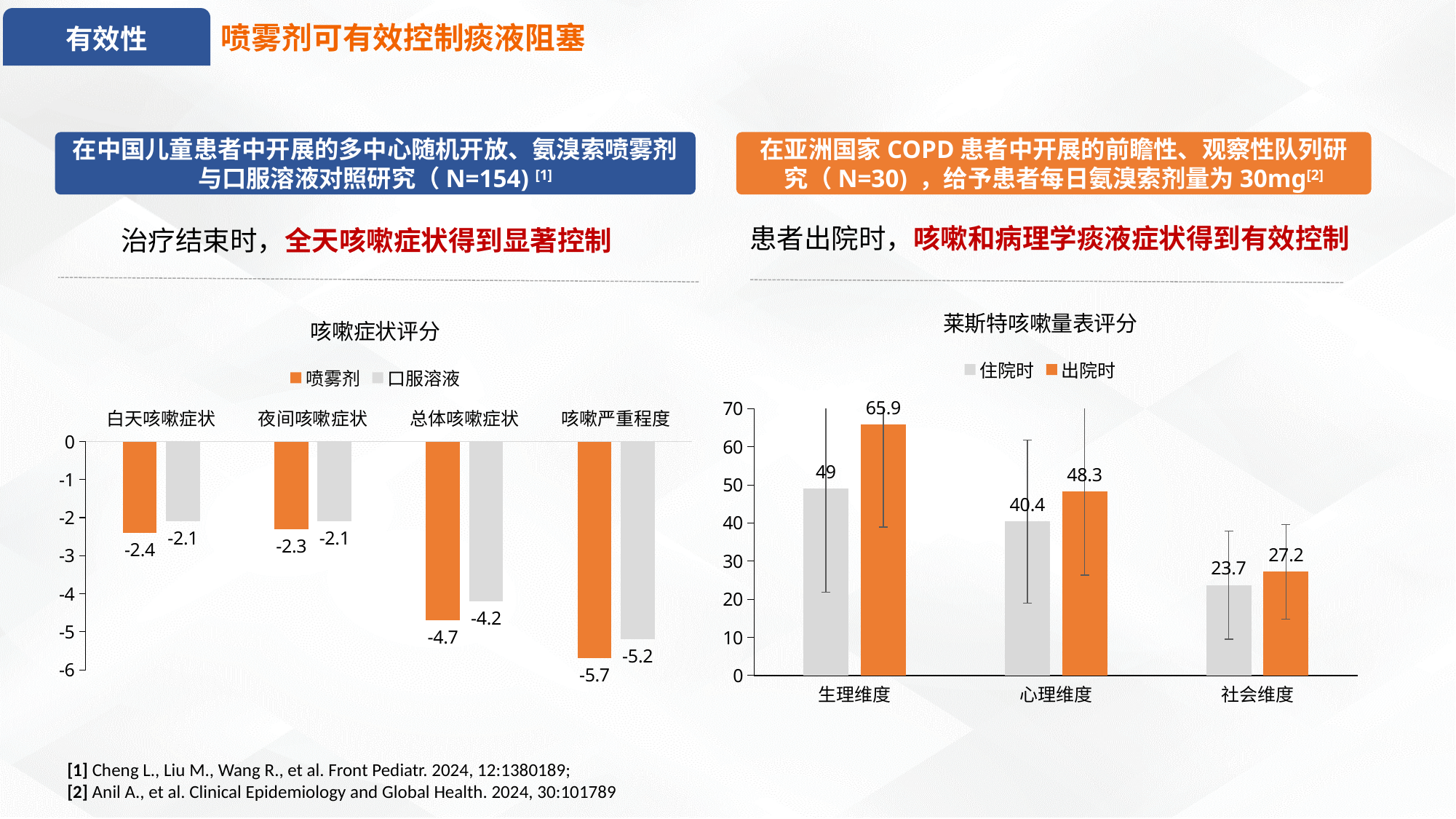
In the 莱斯特咳嗽量表评分 chart, what is the 住院时 value for 心理维度? 40.4 What kind of chart is the 莱斯特咳嗽量表评分 chart? Bar chart In the 莱斯特咳嗽量表评分 chart, what is the difference between the 出院时 and 住院时 values for 社会维度? 3.5 In the 咳嗽症状评分 chart, what is the value for 喷雾剂 in the 总体咳嗽症状 category? -4.7 In the 咳嗽症状评分 chart, how many series does the legend list? 2 In the 咳嗽症状评分 chart, what is the value for 口服溶液 in the 咳嗽严重程度 category? -5.2 In the 咳嗽症状评分 chart, what is the difference between the 喷雾剂 and 口服溶液 values for 白天咳嗽症状? 0.3 In the 咳嗽症状评分 chart, how many categories are shown on the x axis? 4 In the 咳嗽症状评分 chart, which category has the lowest (most negative) 喷雾剂 value? 咳嗽严重程度 In the 莱斯特咳嗽量表评分 chart, which is larger for 心理维度: the 住院时 value or the 出院时 value? 出院时 In the 莱斯特咳嗽量表评分 chart, which category has the highest 出院时 value? 生理维度 In the 莱斯特咳嗽量表评分 chart, what is the 出院时 value for 生理维度? 65.9